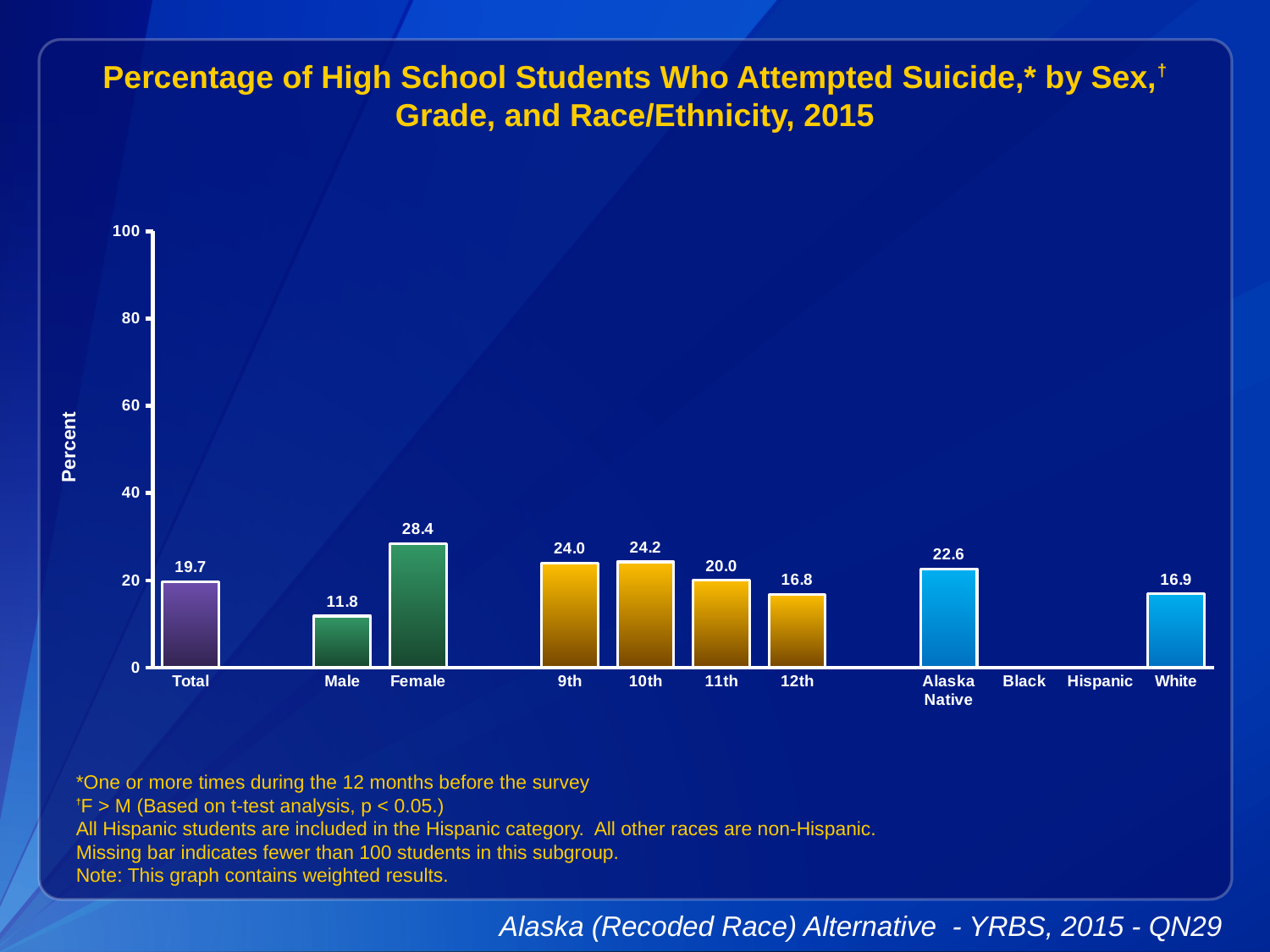
Which race/ethnicity categories have no bar shown? Black and Hispanic Which category with a bar has the lowest value? Male What is the value for Total? 19.7 What is the value for 12th grade? 16.8 What kind of chart is shown? bar chart What is the value for Female? 28.4 How many categories are labeled on the x axis? 11 Is the value for 10th grade greater or less than 20? greater Which is larger, the value for 9th grade or the value for 11th grade? 9th What is the value for Alaska Native? 22.6 What is the difference between the Female and Male values? 16.6 Which category has the highest value? Female